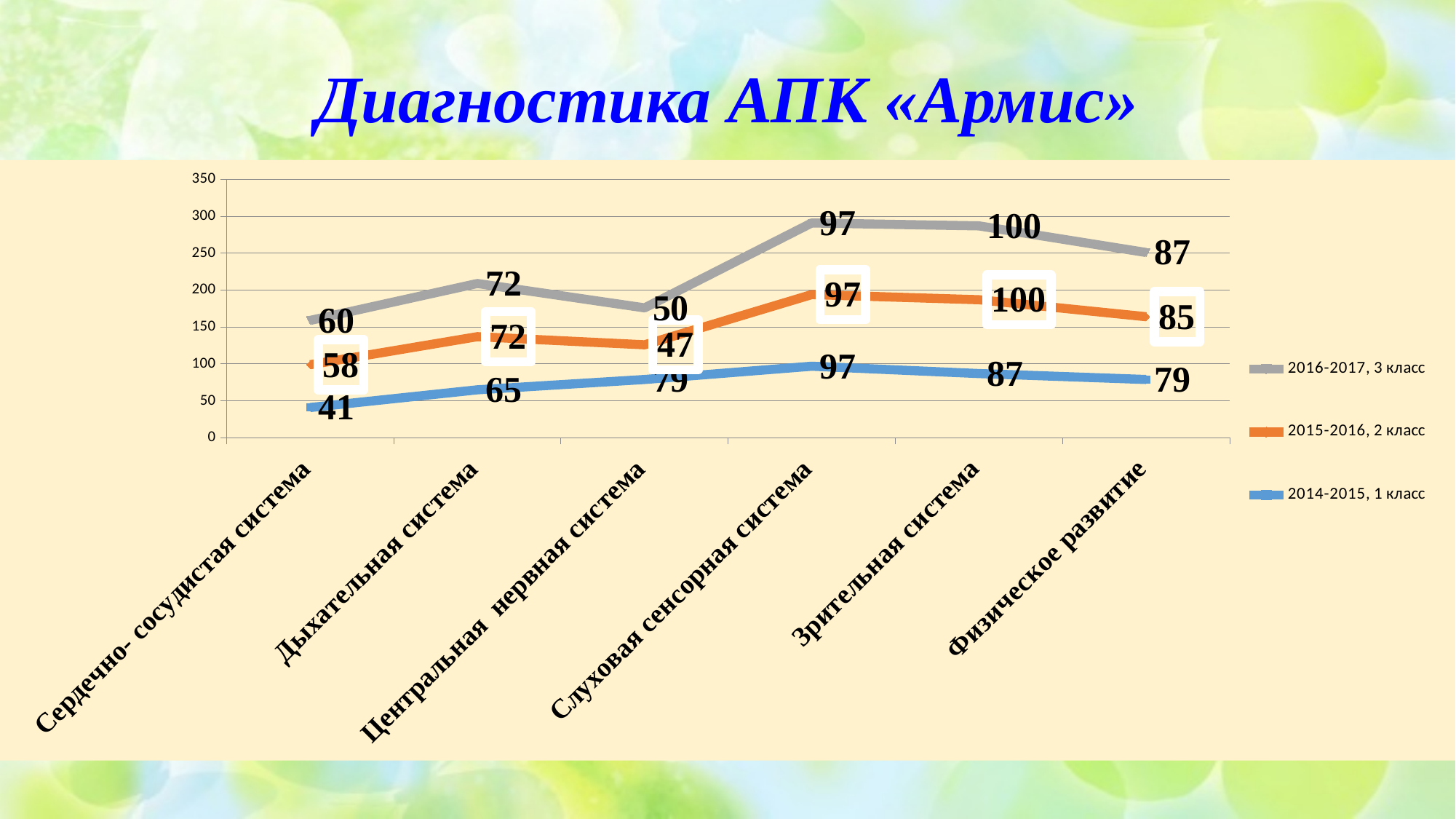
How many series does the legend list? 3 What is the value for Сердечно-сосудистая система in the 2014-2015, 1 класс series? 41 What is the difference between the 2014-2015, 1 класс and 2015-2016, 2 класс values for Центральная нервная система? 32 What kind of chart is shown on the slide? Line chart Which is larger for Дыхательная система: the 2014-2015, 1 класс value or the 2015-2016, 2 класс value? 2015-2016, 2 класс What is the value for Физическое развитие in the 2016-2017, 3 класс series? 87 Which category has the lowest value in the 2014-2015, 1 класс series? Сердечно-сосудистая система What is the value for Центральная нервная система in the 2015-2016, 2 класс series? 47 Which category has the lowest value in the 2016-2017, 3 класс series? Центральная нервная система What is the value for Зрительная система in the 2014-2015, 1 класс series? 87 What is the difference between the 2016-2017, 3 класс and 2014-2015, 1 класс values for Сердечно-сосудистая система? 19 How many categories are shown on the x axis? 6